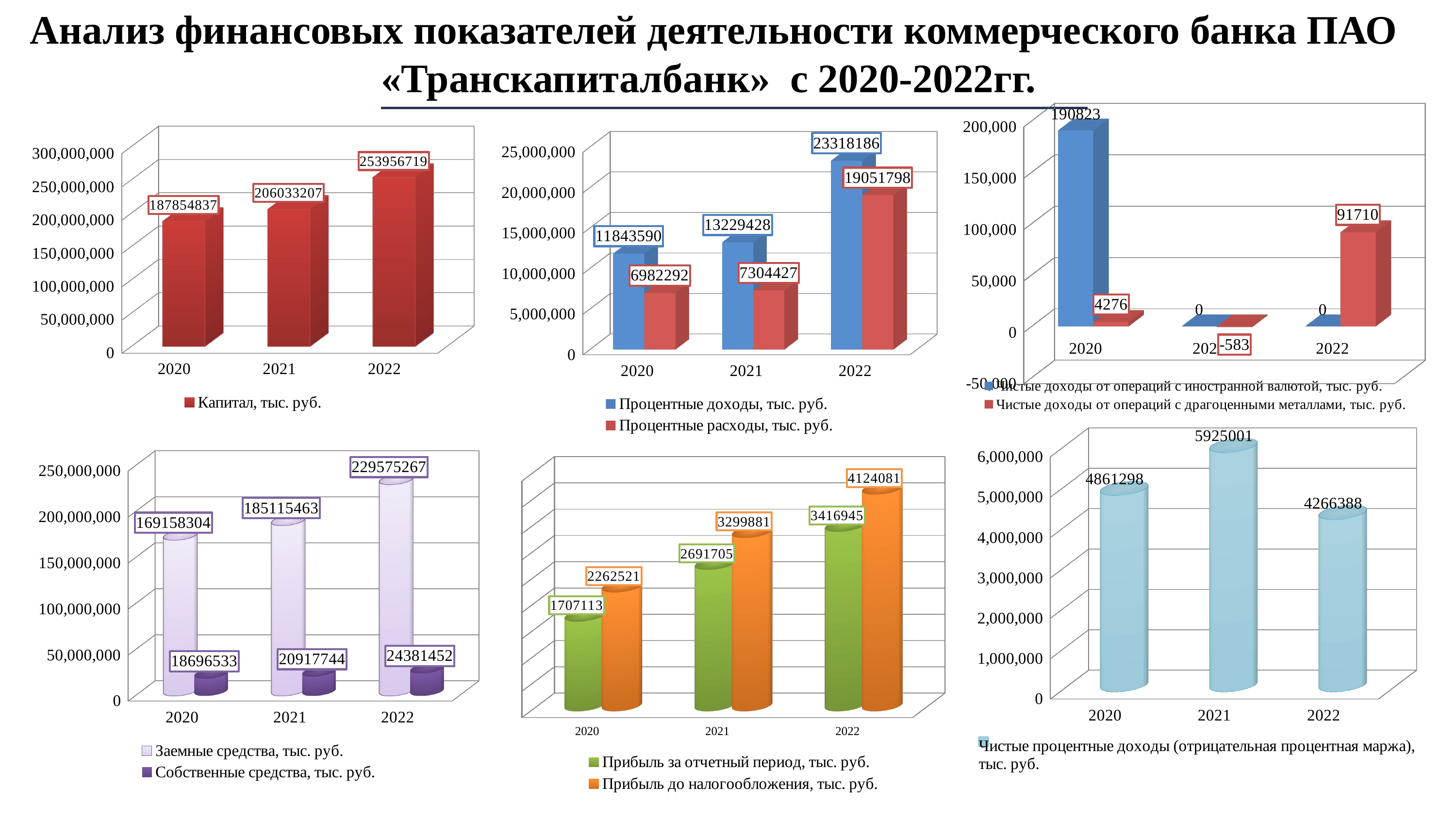
In the bottom-middle chart, what is the value of Прибыль до налогообложения, тыс. руб. for 2020? 2262521 In the bottom-left chart, what is the value of Собственные средства, тыс. руб. for 2021? 20917744 How many series does the legend of the bottom-middle chart list? 2 In the bottom-middle chart, does Прибыль за отчетный период rise or fall from 2020 to 2022? rise In the top-left chart (Капитал, тыс. руб.), what is the value for 2022? 253956719 In the bottom-right chart (Чистые процентные доходы), which year has the highest value? 2021 In the top-right chart, what is the value of Чистые доходы от операций с драгоценными металлами, тыс. руб. for 2022? 91710 In the top-middle chart, what is the difference between Процентные доходы and Процентные расходы in 2022? 4266388 In the top-right chart, what is the value of Чистые доходы от операций с иностранной валютой, тыс. руб. for 2020? 190823 In the bottom-left chart, which is larger in 2022: Заемные средства or Собственные средства? Заемные средства In the top-middle chart, what is the value of Процентные расходы, тыс. руб. for 2021? 7304427 In the top-left chart (Капитал, тыс. руб.), which year has the lowest value? 2020